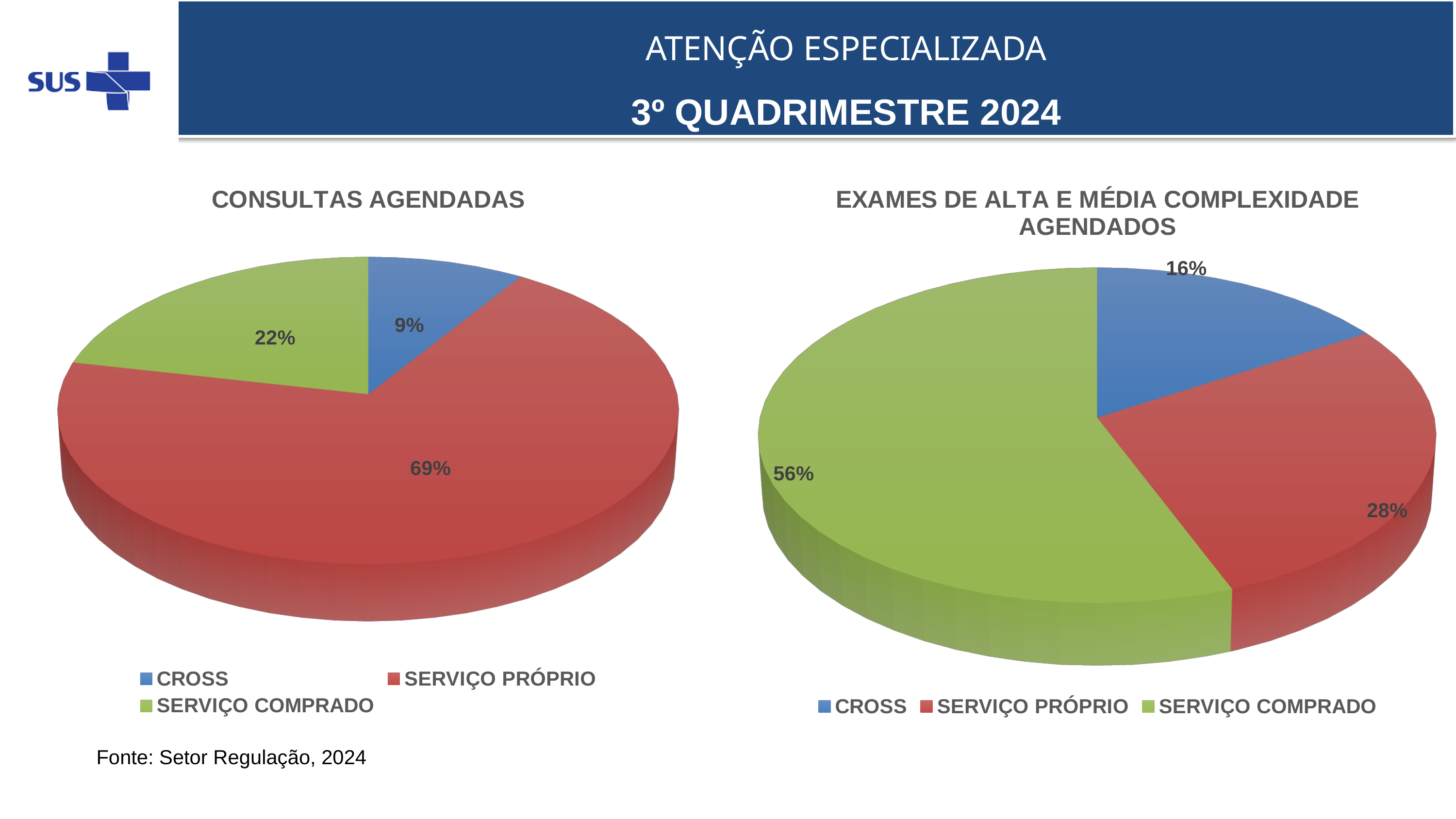
In the CONSULTAS AGENDADAS chart, what share does CROSS have? 9% In the EXAMES DE ALTA E MÉDIA COMPLEXIDADE AGENDADOS chart, what share does SERVIÇO COMPRADO have? 56% In the EXAMES DE ALTA E MÉDIA COMPLEXIDADE AGENDADOS chart, which category has the largest slice? SERVIÇO COMPRADO How many categories does the legend of the EXAMES DE ALTA E MÉDIA COMPLEXIDADE AGENDADOS chart list? 3 In the CONSULTAS AGENDADAS chart, what share does SERVIÇO PRÓPRIO have? 69% In the CONSULTAS AGENDADAS chart, which category has the smallest slice? CROSS What kind of chart is the CONSULTAS AGENDADAS chart? Pie chart In the EXAMES DE ALTA E MÉDIA COMPLEXIDADE AGENDADOS chart, which is larger, SERVIÇO PRÓPRIO or CROSS? SERVIÇO PRÓPRIO In the EXAMES DE ALTA E MÉDIA COMPLEXIDADE AGENDADOS chart, what share does CROSS have? 16% In the CONSULTAS AGENDADAS chart, what is the difference between the SERVIÇO PRÓPRIO and SERVIÇO COMPRADO shares? 47% In the CONSULTAS AGENDADAS chart, what share does SERVIÇO COMPRADO have? 22% In the CONSULTAS AGENDADAS chart, which category has the largest slice? SERVIÇO PRÓPRIO